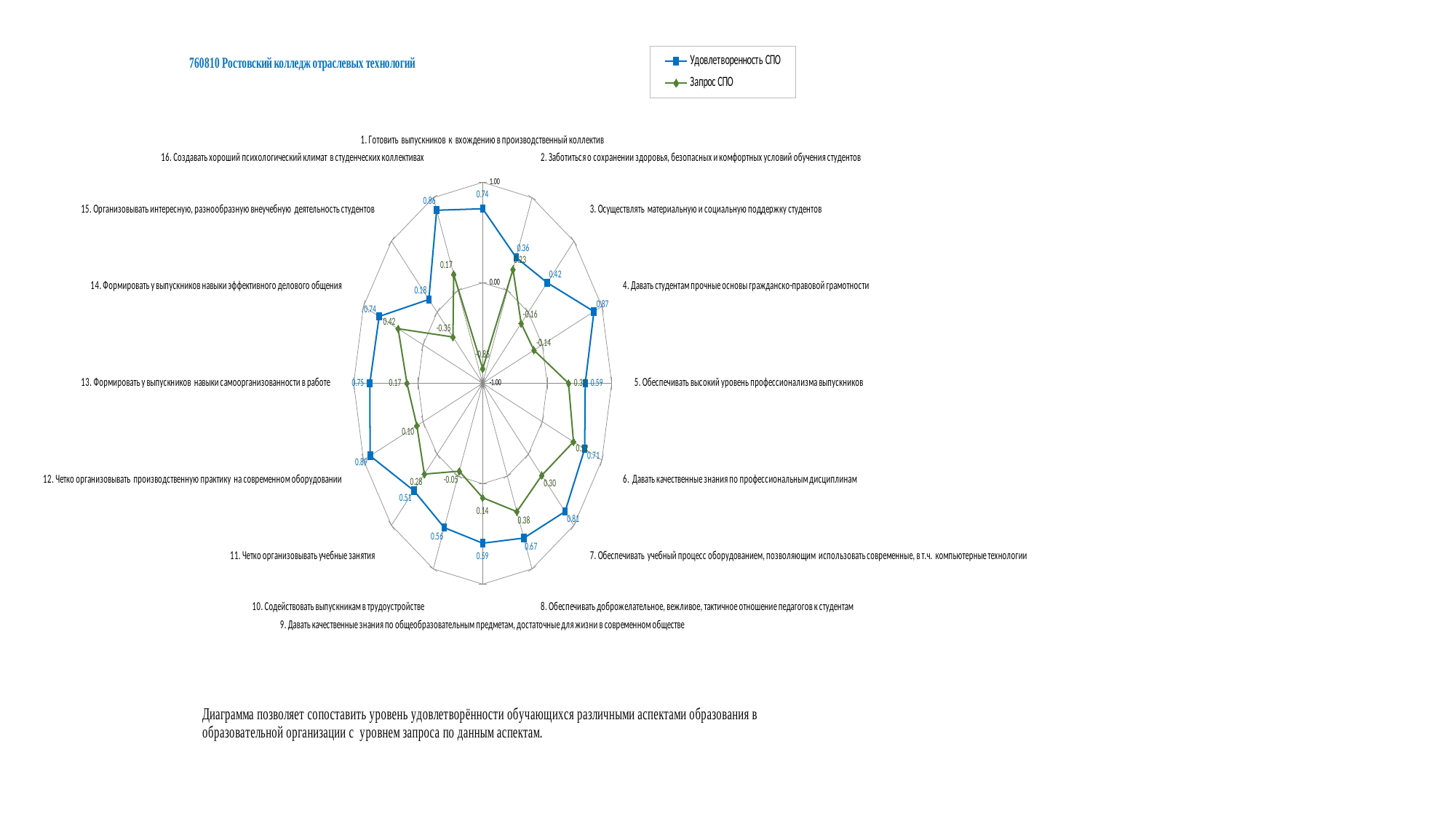
For category 1 (Готовить выпускников к вхождению в производственный коллектив), what is the difference between "Удовлетворенность СПО" and "Запрос СПО"? 1.59 For "Удовлетворенность СПО", which is larger: category 13 (навыки самоорганизованности в работе) or category 11 (Четко организовывать учебные занятия)? Category 13 What is the value of "Запрос СПО" for category 14 (Формировать у выпускников навыки эффективного делового общения)? 0.42 What is the value of "Удовлетворенность СПО" for category 16 (Создавать хороший психологический климат в студенческих коллективах)? 0.86 Which category has the highest value for "Удовлетворенность СПО"? 12. Четко организовывать производственную практику на современном оборудовании What are the two series named in the legend? Удовлетворенность СПО and Запрос СПО How many series does the legend list? 2 How many categories (axes) does the radar chart have? 16 What is the value of "Запрос СПО" for category 15 (Организовывать интересную, разнообразную внеучебную деятельность студентов)? -0.35 Which category has the lowest value for "Удовлетворенность СПО"? 15. Организовывать интересную, разнообразную внеучебную деятельность студентов What kind of chart is shown on the slide? Radar chart What is the value of "Удовлетворенность СПО" for category 4 (Давать студентам прочные основы гражданско-правовой грамотности)? 0.87